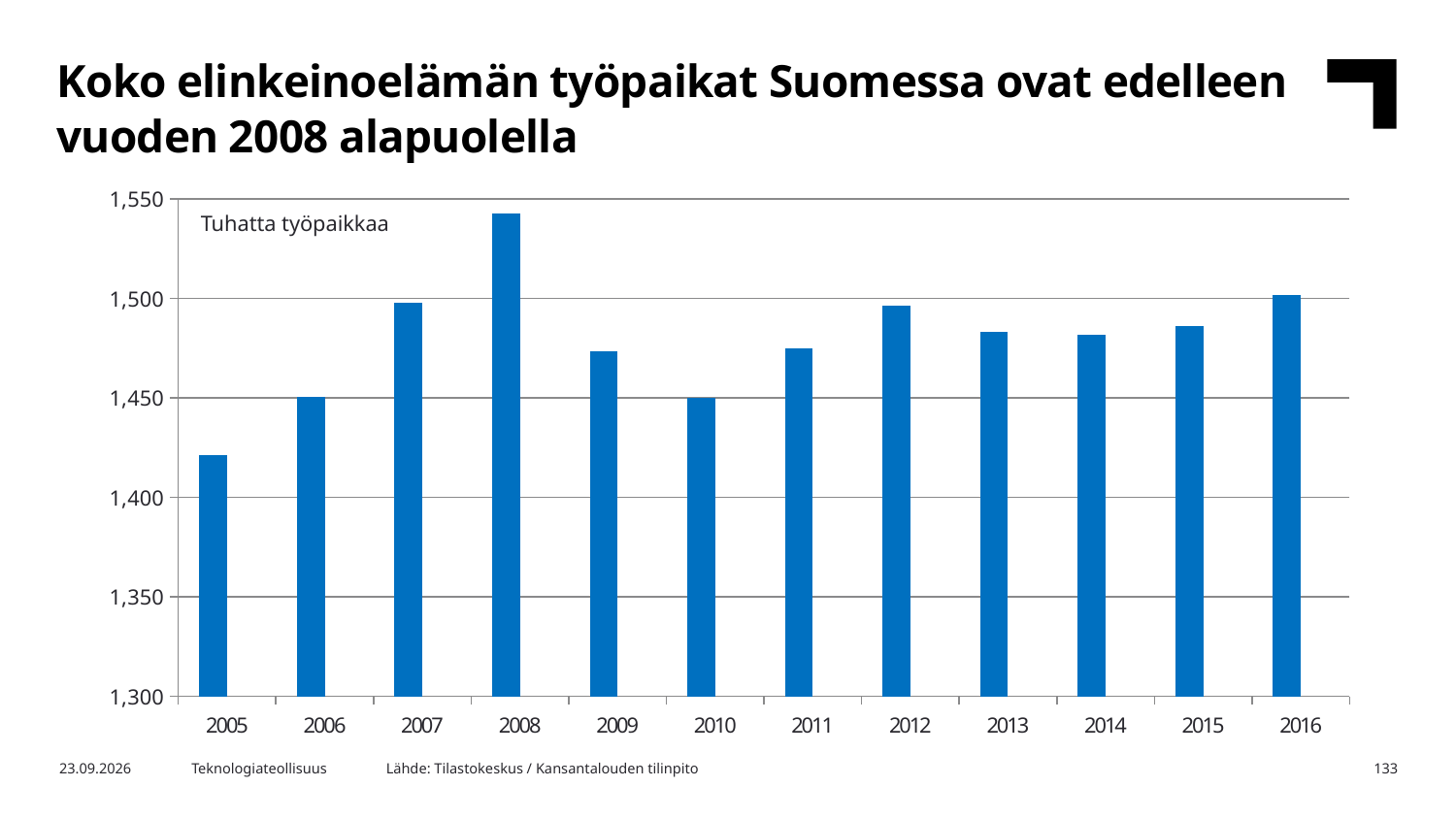
Is the value for 2008 greater or less than 1,500? greater How many years are shown on the x axis of the chart? 12 Is the value for 2012 greater or less than 1,500? less Is the value for 2009 greater or less than 1,450? greater Which year has the highest number of jobs in the chart? 2008 What kind of chart is shown on the slide? bar chart What unit label is shown inside the chart area? Tuhatta työpaikkaa Which year has the larger value, 2012 or 2010? 2012 Which year has the lowest number of jobs in the chart? 2005 Do the values rise or fall from 2005 to 2008? rise Which year has the larger value, 2008 or 2005? 2008